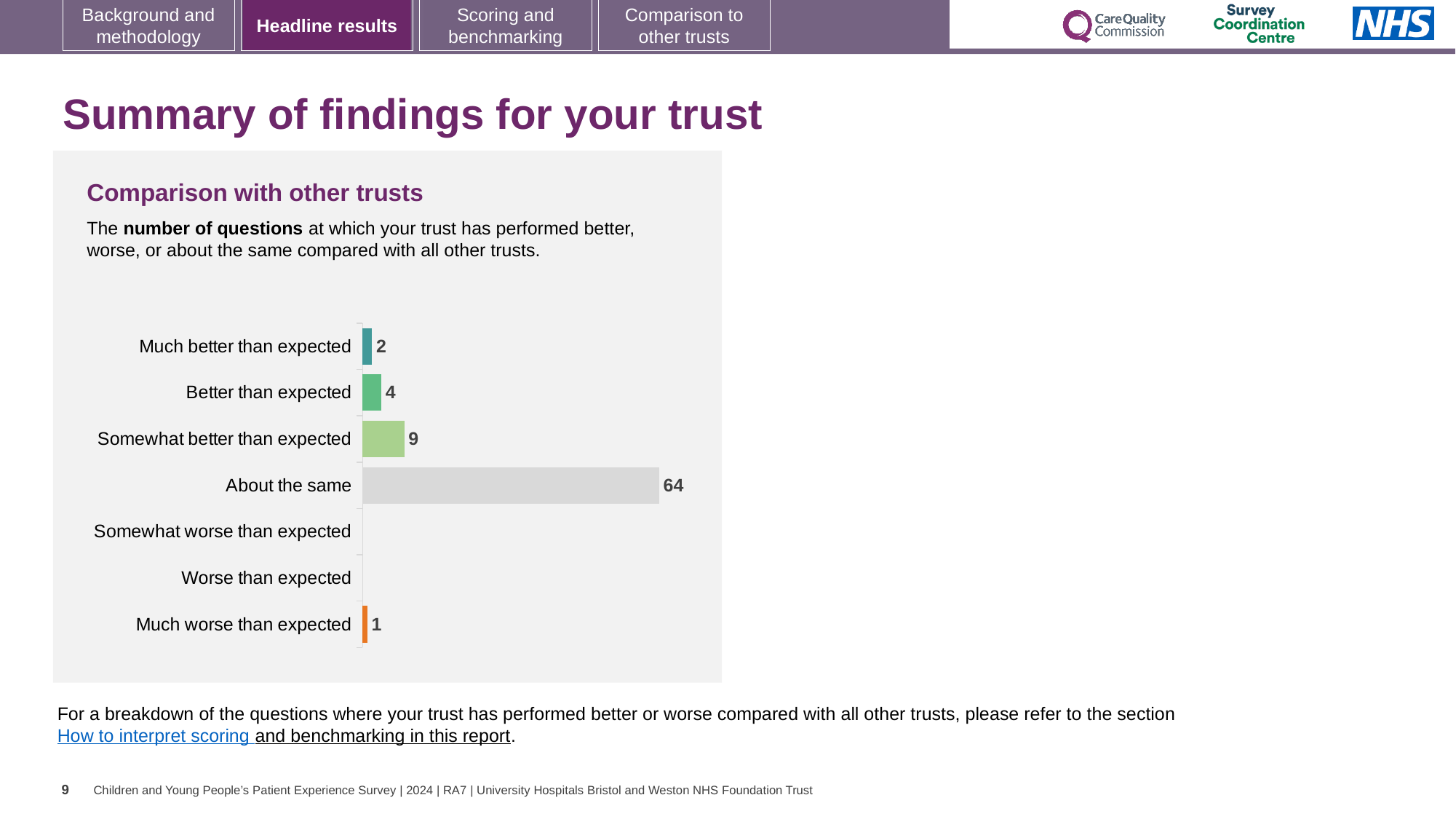
What kind of chart is shown on the slide? Bar chart Which category has the highest number of questions? About the same How many questions are in the 'About the same' category? 64 What is the difference between 'Better than expected' and 'Much better than expected'? 2 What is the value for 'Better than expected'? 4 What is the value for 'Much worse than expected'? 1 What colour is the bar for 'Much worse than expected'? Orange How many categories are listed on the chart? 7 What is the value for 'Somewhat better than expected'? 9 What is the difference between 'About the same' and 'Somewhat better than expected'? 55 What is the title of the chart? Comparison with other trusts Which is larger, 'Somewhat better than expected' or 'Better than expected'? Somewhat better than expected